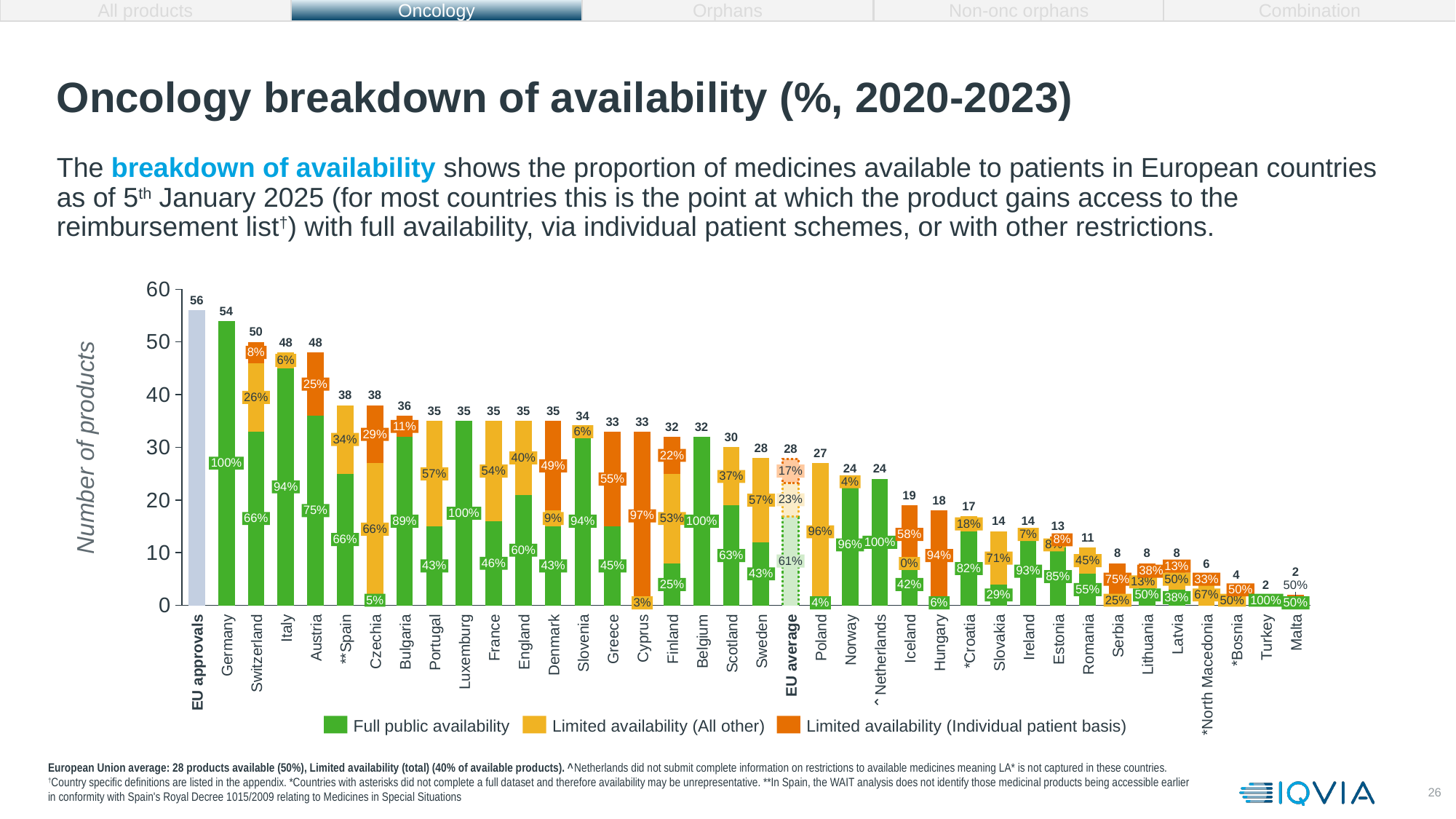
What percentage of Germany's bar is Full public availability? 100% Which has a larger total, Italy or Czechia? Italy What is the total number of products shown for Poland? 27 Is the total for Iceland greater or less than 20? less How many series does the legend list? 3 What is the label of the y axis? Number of products What kind of chart is shown on the slide? Stacked bar chart Do the bar totals rise or fall moving from left to right along the x axis? Fall Which category has the tallest bar in the chart? EU approvals What is the difference between the totals for Germany and Switzerland? 4 What is the difference between the totals for EU approvals and EU average? 28 What is the total number of products shown for Germany? 54